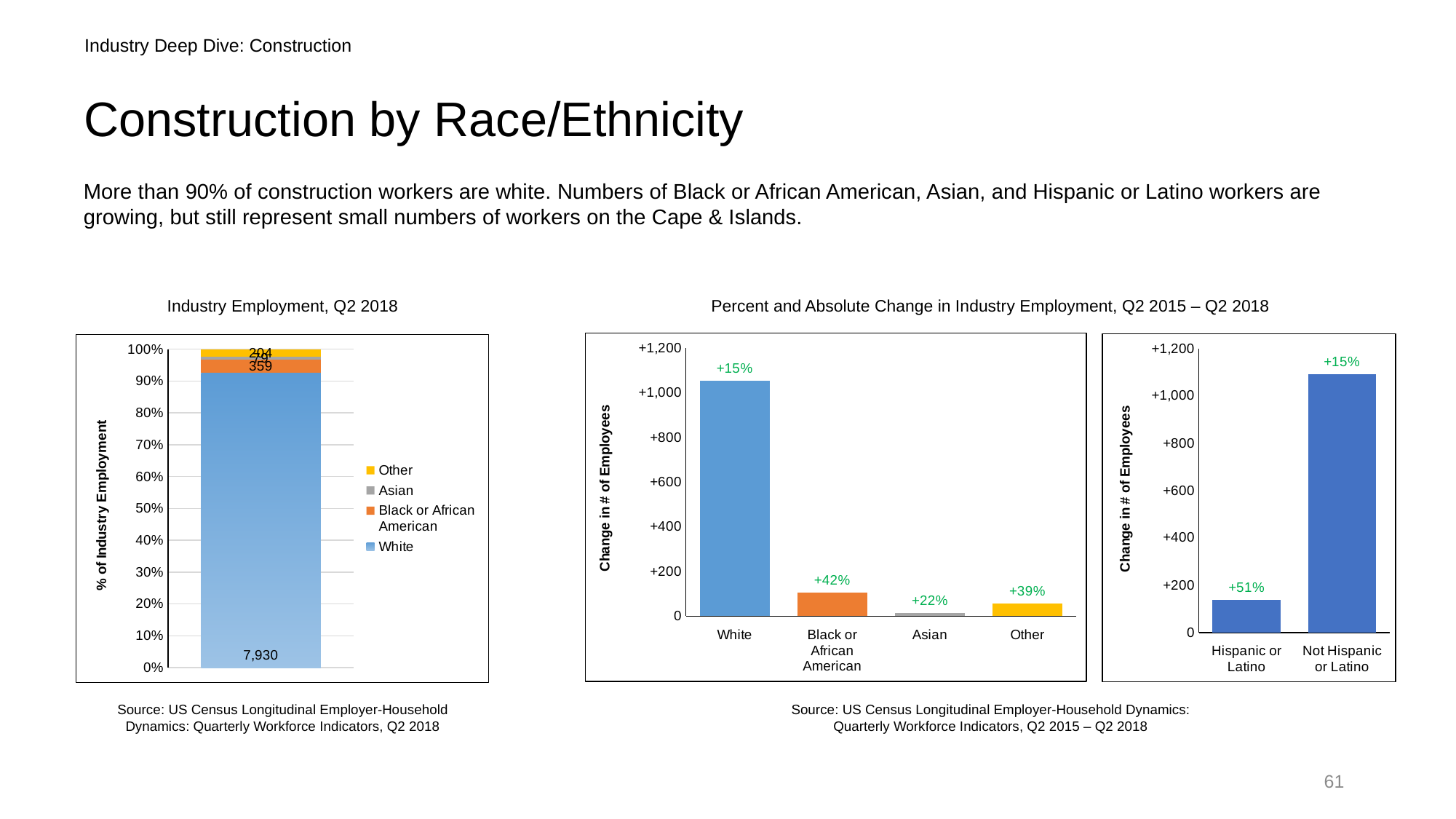
What kind of chart is the Industry Employment, Q2 2018 chart? bar chart In the Industry Employment, Q2 2018 chart, what is the value shown for White? 7,930 In the rightmost chart (change in employment by Hispanic or Latino status), what percent change is labeled for Hispanic or Latino? +51% In the middle chart (Percent and Absolute Change in Industry Employment by race), what percent change is labeled for Other? +39% How many categories are shown on the x axis of the middle chart (Percent and Absolute Change in Industry Employment by race)? 4 In the middle chart (Percent and Absolute Change in Industry Employment by race), what percent change is labeled for Black or African American? +42% In the middle chart (Percent and Absolute Change in Industry Employment by race), is the change in number of employees for White greater or less than +800? greater How many series does the legend of the Industry Employment, Q2 2018 chart list? 4 In the middle chart (Percent and Absolute Change in Industry Employment by race), which category has the largest change in number of employees? White In the Industry Employment, Q2 2018 chart, what is the value shown for Black or African American? 359 In the middle chart (Percent and Absolute Change in Industry Employment by race), which category has the smallest change in number of employees? Asian In the rightmost chart (change in employment by Hispanic or Latino status), which category has the larger change in number of employees, Hispanic or Latino or Not Hispanic or Latino? Not Hispanic or Latino